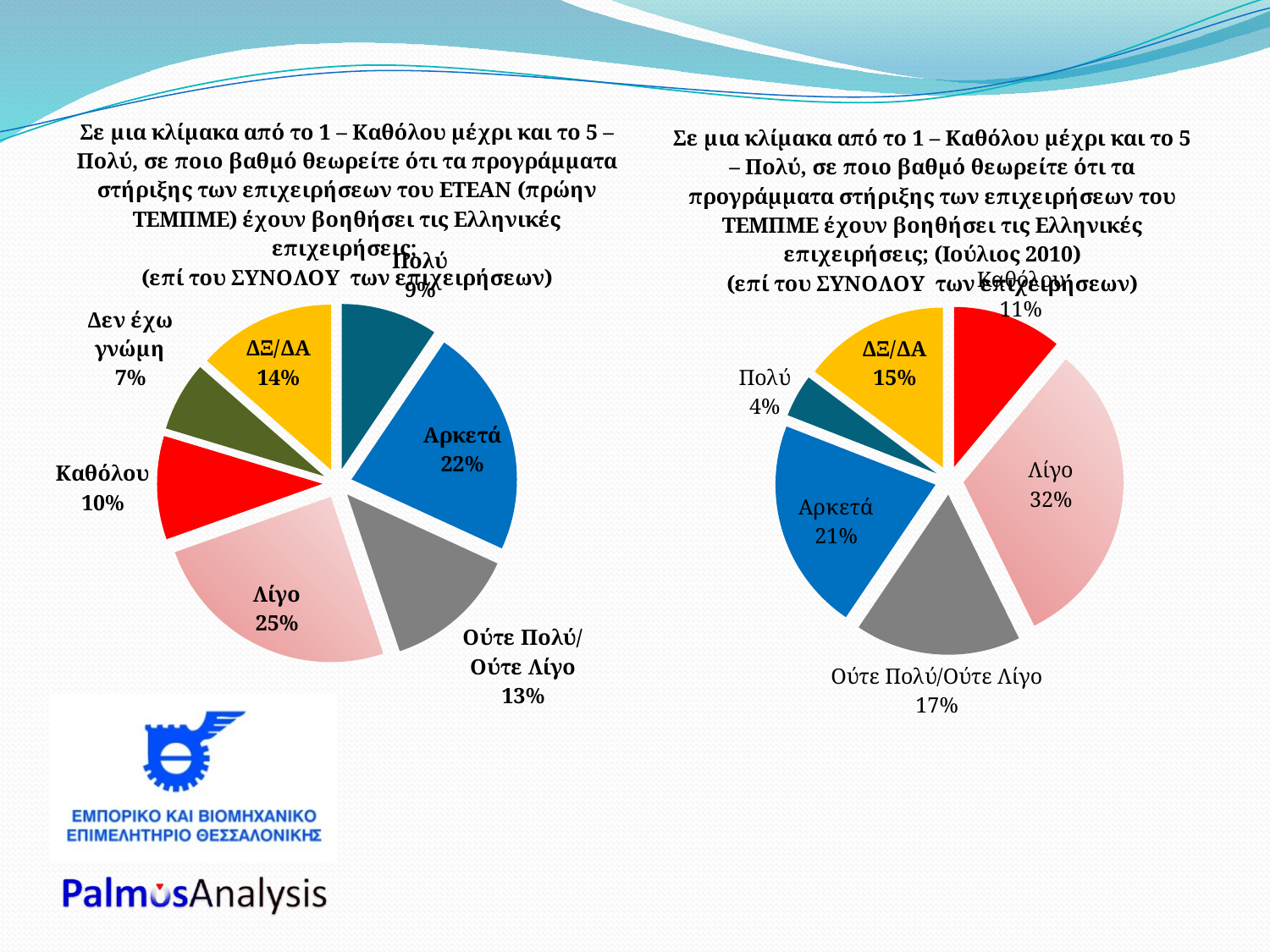
In the left pie chart, what share is labelled Λίγο? 25% In the right pie chart (Ιούλιος 2010), which category has the smallest share? Πολύ In the right pie chart (Ιούλιος 2010), how many slices does the pie have? 6 In the right pie chart (Ιούλιος 2010), what percentage answered Πολύ? 4% In the left pie chart, how many slices does the pie have? 7 In the right pie chart (Ιούλιος 2010), what percentage answered Λίγο? 32% In the left pie chart, what is the difference between the Αρκετά and Πολύ shares? 13% What type of chart is used on this slide? Pie chart In the left pie chart, which category has the smallest share? Δεν έχω γνώμη In the right pie chart (Ιούλιος 2010), which is larger: Αρκετά or Ούτε Πολύ/Ούτε Λίγο? Αρκετά In the left pie chart, which category has the largest share? Λίγο In the left pie chart, what percentage of businesses answered Αρκετά? 22%